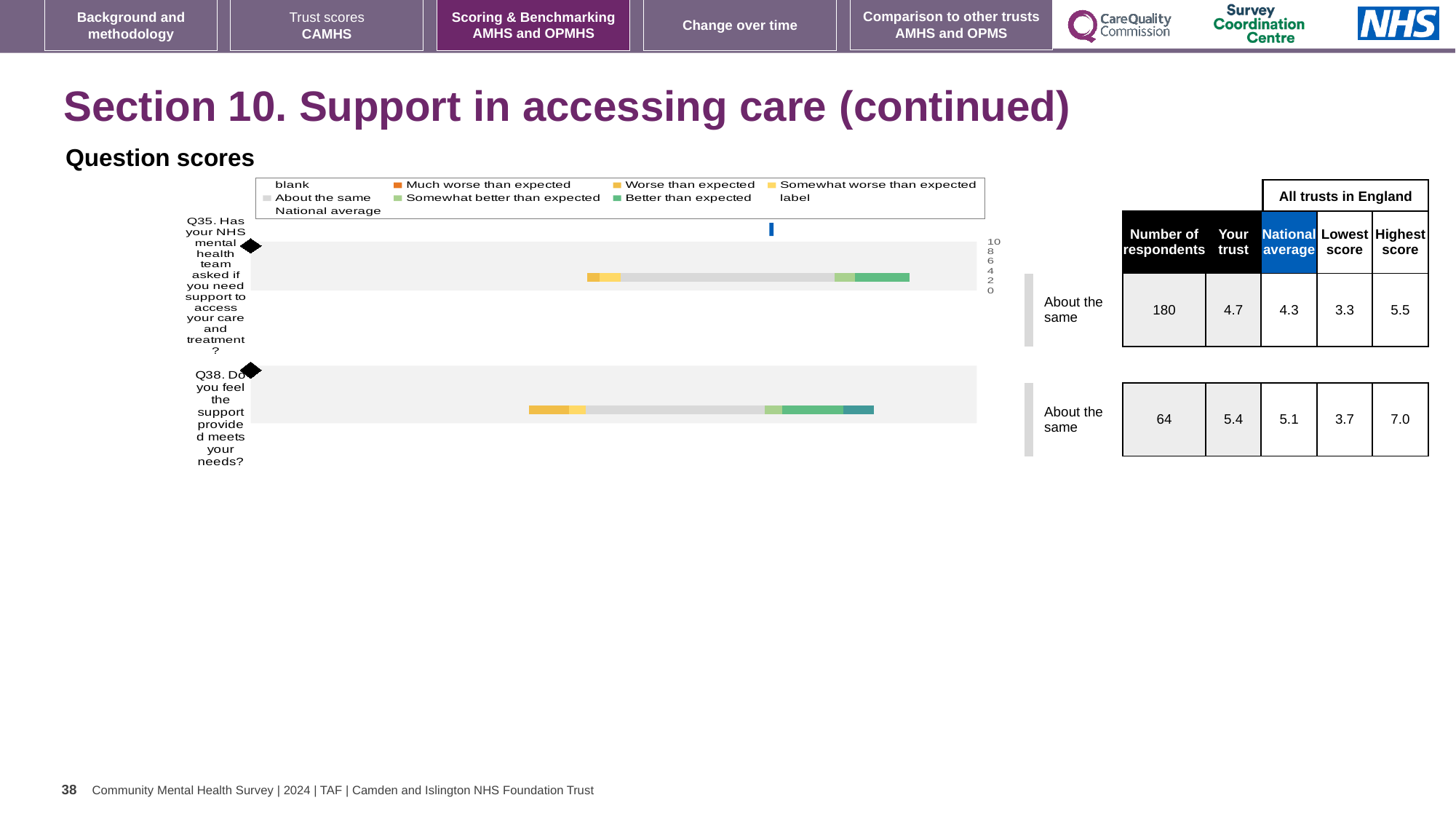
What is the national average score for Q38? 5.1 How many respondents answered Q35? 180 What kind of chart is used to show the question scores? bar chart What does the dark blue marker in the legend represent? National average What is the highest score among all trusts in England for Q38? 7.0 What is the difference between the highest and lowest scores for Q38? 3.3 How many questions are plotted in the Question scores chart? 2 What is the 'Your trust' score for Q35? 4.7 Which question has more respondents, Q35 or Q38? Q35 What benchmark category is shown for Q38? About the same For Q35, which is larger: the 'Your trust' score or the national average? Your trust What is the title of the chart? Question scores